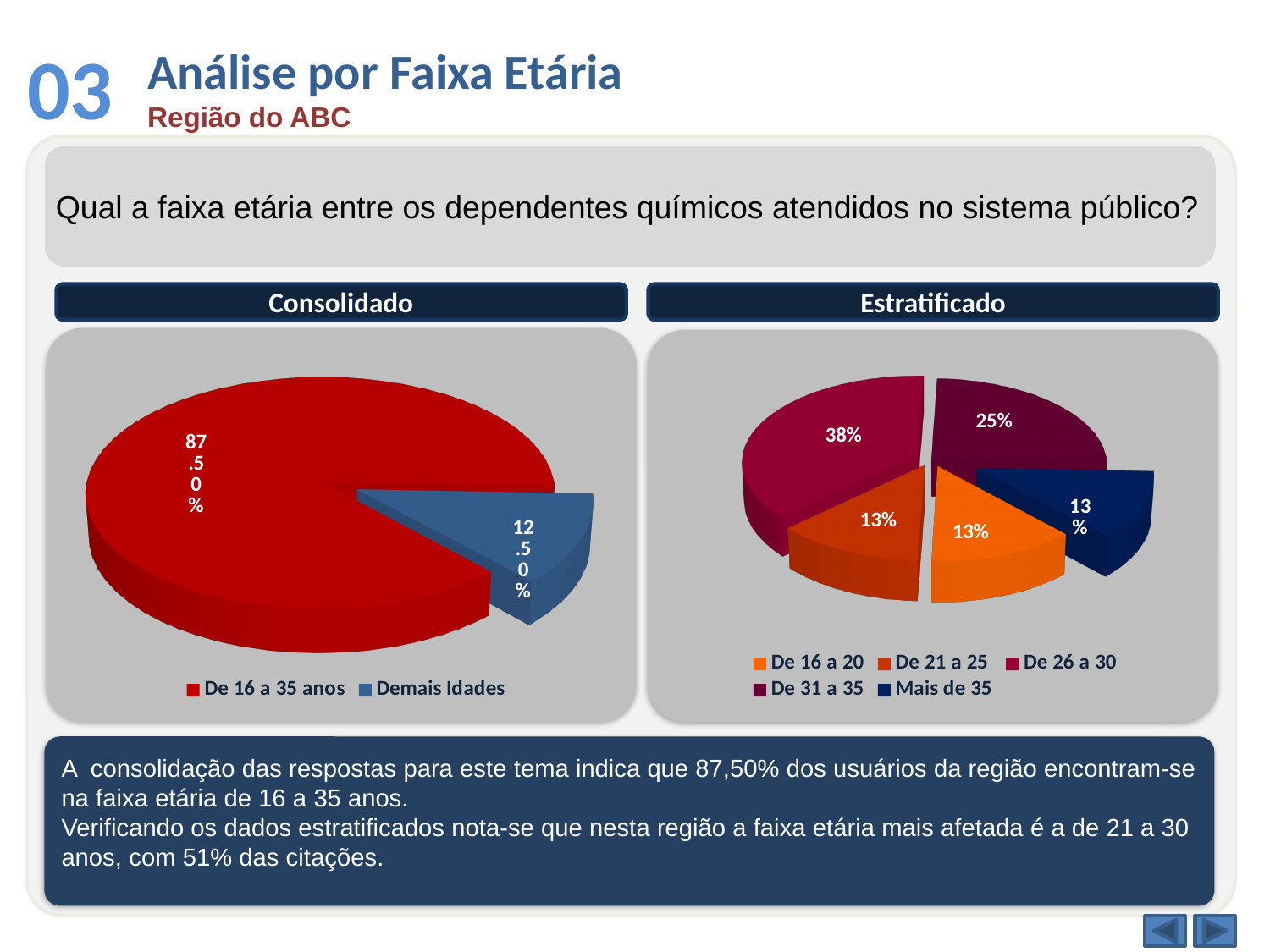
In the Estratificado chart, which age group has the largest share? De 26 a 30 What kind of chart is the Consolidado chart? Pie chart How many categories does the Estratificado chart's legend list? 5 In the Consolidado chart, what is the value for Demais Idades? 12.50% In the Estratificado chart, what is the value for De 31 a 35? 25% In the Estratificado chart, what is the value for Mais de 35? 13% In the Consolidado chart, what is the value for De 16 a 35 anos? 87.50% In the Estratificado chart, what is the value for De 26 a 30? 38% In the Estratificado chart, which is larger, De 31 a 35 or De 16 a 20? De 31 a 35 How many categories does the Consolidado chart's legend list? 2 In the Estratificado chart, what is the difference between De 26 a 30 and De 31 a 35? 13 percentage points In the Consolidado chart, what is the difference between De 16 a 35 anos and Demais Idades? 75 percentage points